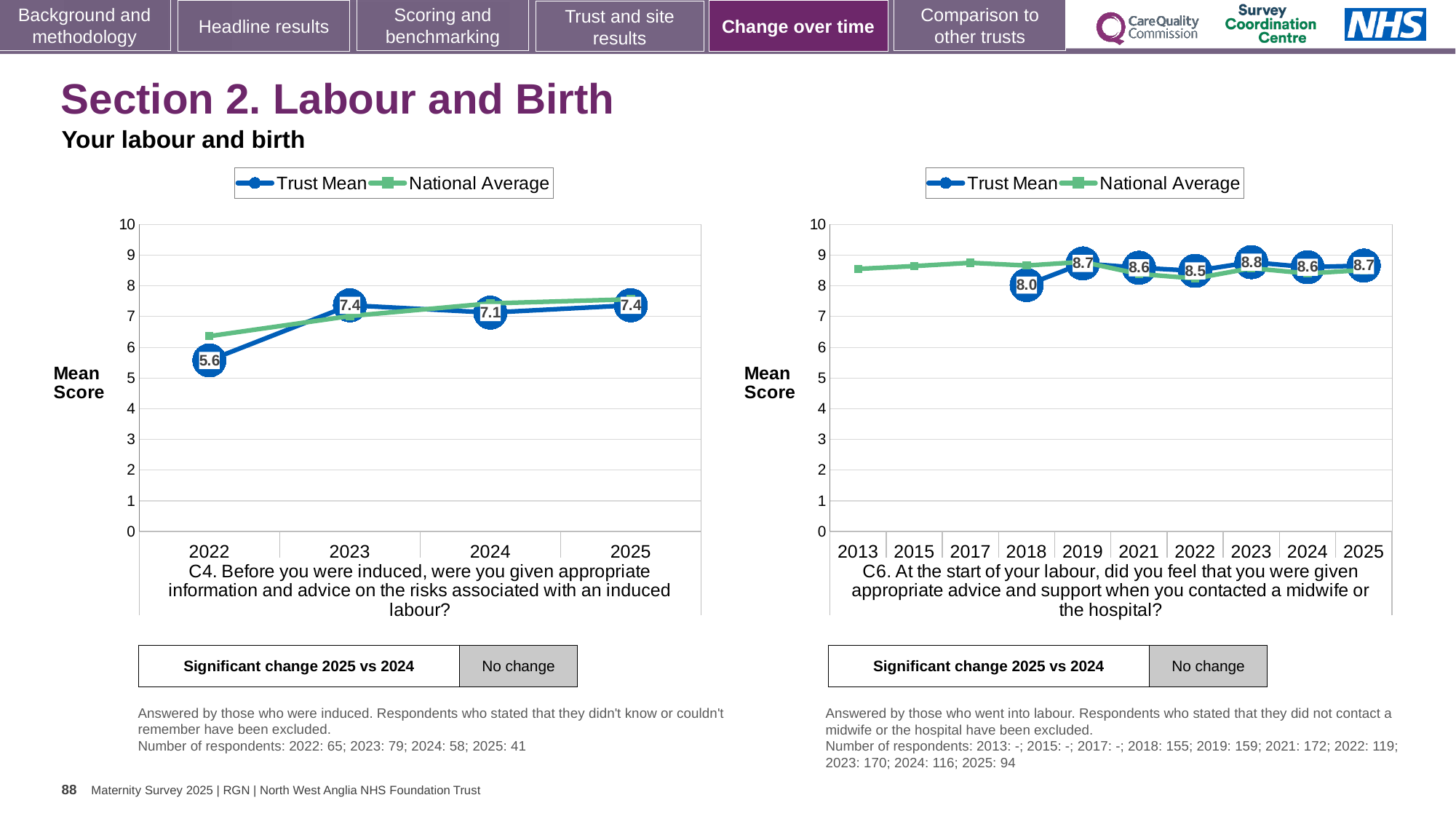
In the right chart (C6), how many years are shown on the x axis? 10 In the left chart (C4), what is the Trust Mean for 2022? 5.6 In the left chart (C4), what is the difference between the Trust Mean in 2023 and in 2022? 1.8 In the left chart (C4), how many years are shown on the x axis? 4 In the left chart (C4), which year has the lowest Trust Mean? 2022 In the right chart (C6), which year has the highest Trust Mean? 2023 In the left chart (C4), is the National Average for 2022 greater or less than 6? greater How many series does the legend of the right chart (C6) list? 2 In the right chart (C6), which is larger, the Trust Mean for 2019 or for 2022? 2019 In the left chart (C4), what is the Trust Mean for 2024? 7.1 In the right chart (C6), what is the Trust Mean for 2018? 8.0 What kind of chart is the left chart (C4)? Line chart